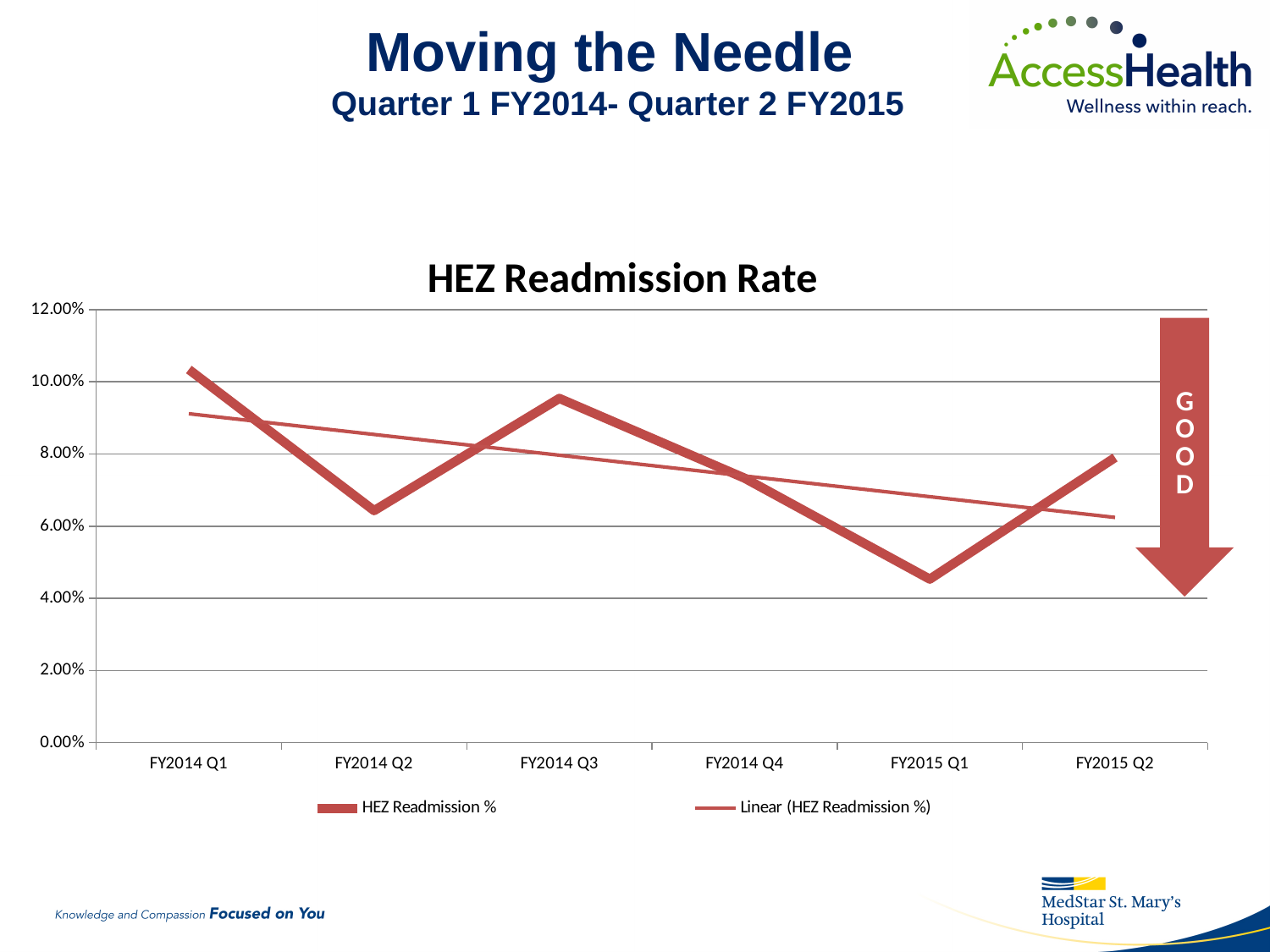
Does the Linear (HEZ Readmission %) trend line rise or fall from FY2014 Q1 to FY2015 Q2? fall Is the HEZ Readmission % for FY2015 Q1 greater or less than 6.00%? less Is the HEZ Readmission % for FY2014 Q2 greater or less than 8.00%? less What is the title of the chart? HEZ Readmission Rate Which quarter has the lowest HEZ Readmission %? FY2015 Q1 How many quarters are plotted along the x axis? 6 Is the HEZ Readmission % for FY2014 Q3 greater or less than 8.00%? greater How many series does the legend list? 2 Which has the higher HEZ Readmission %, FY2014 Q2 or FY2014 Q3? FY2014 Q3 Which quarter has the highest HEZ Readmission %? FY2014 Q1 What kind of chart is shown on the slide? line chart